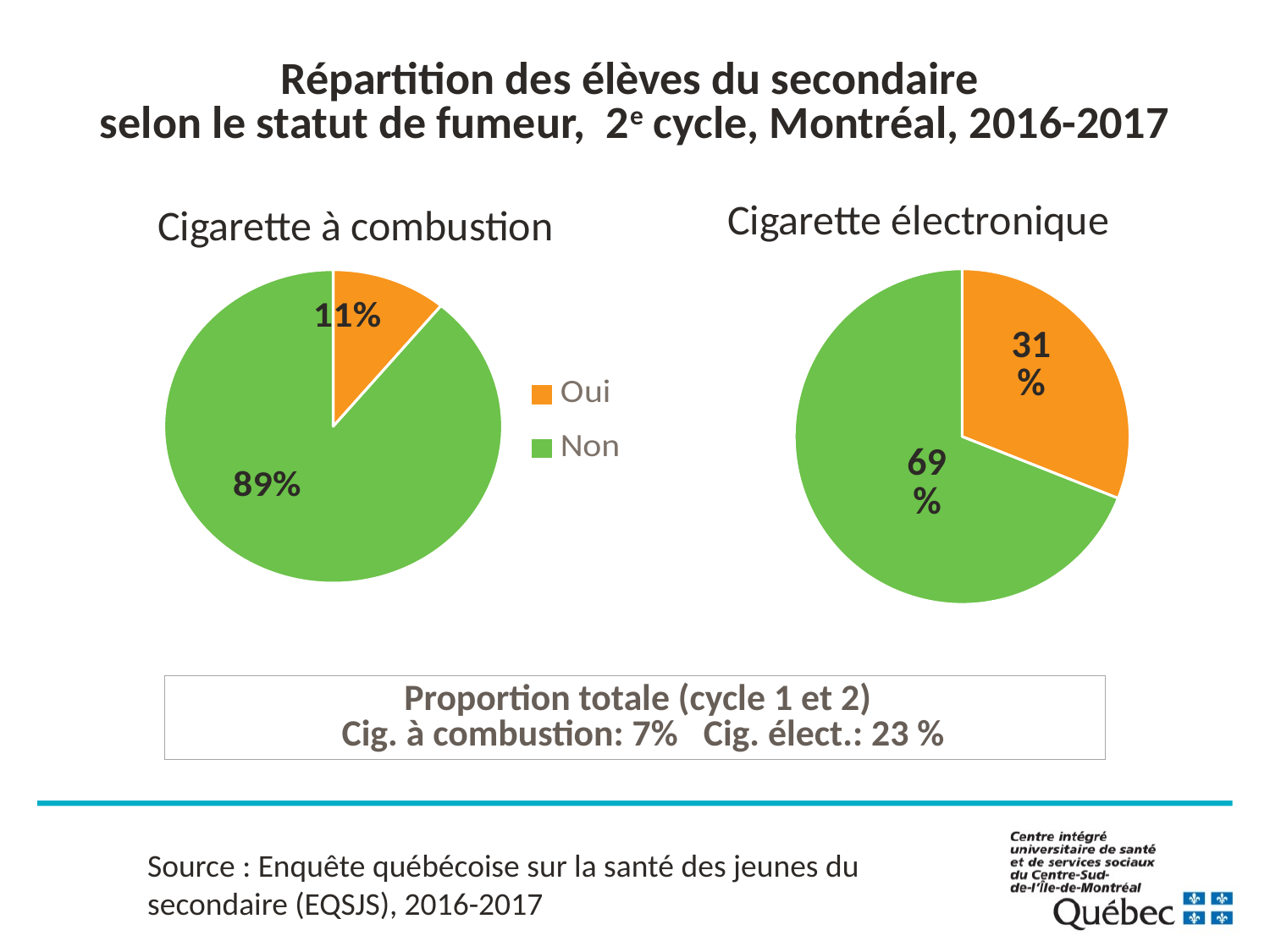
In the 'Cigarette électronique' chart, which category has the largest slice? Non In the 'Cigarette à combustion' chart, what is the value for Non? 89% How many entries does the legend list? 2 How many slices does the 'Cigarette électronique' pie chart have? 2 In the 'Cigarette à combustion' chart, which category has the smallest slice? Oui In the 'Cigarette électronique' chart, what is the difference between Non and Oui? 38% In the 'Cigarette à combustion' chart, what is the value for Oui? 11% What colour represents Oui in the pie charts? Orange In the 'Cigarette électronique' chart, what is the value for Oui? 31% Is the Oui share larger in the 'Cigarette à combustion' chart or in the 'Cigarette électronique' chart? Cigarette électronique What type of chart is used for 'Cigarette à combustion'? Pie chart In the 'Cigarette électronique' chart, what is the value for Non? 69%